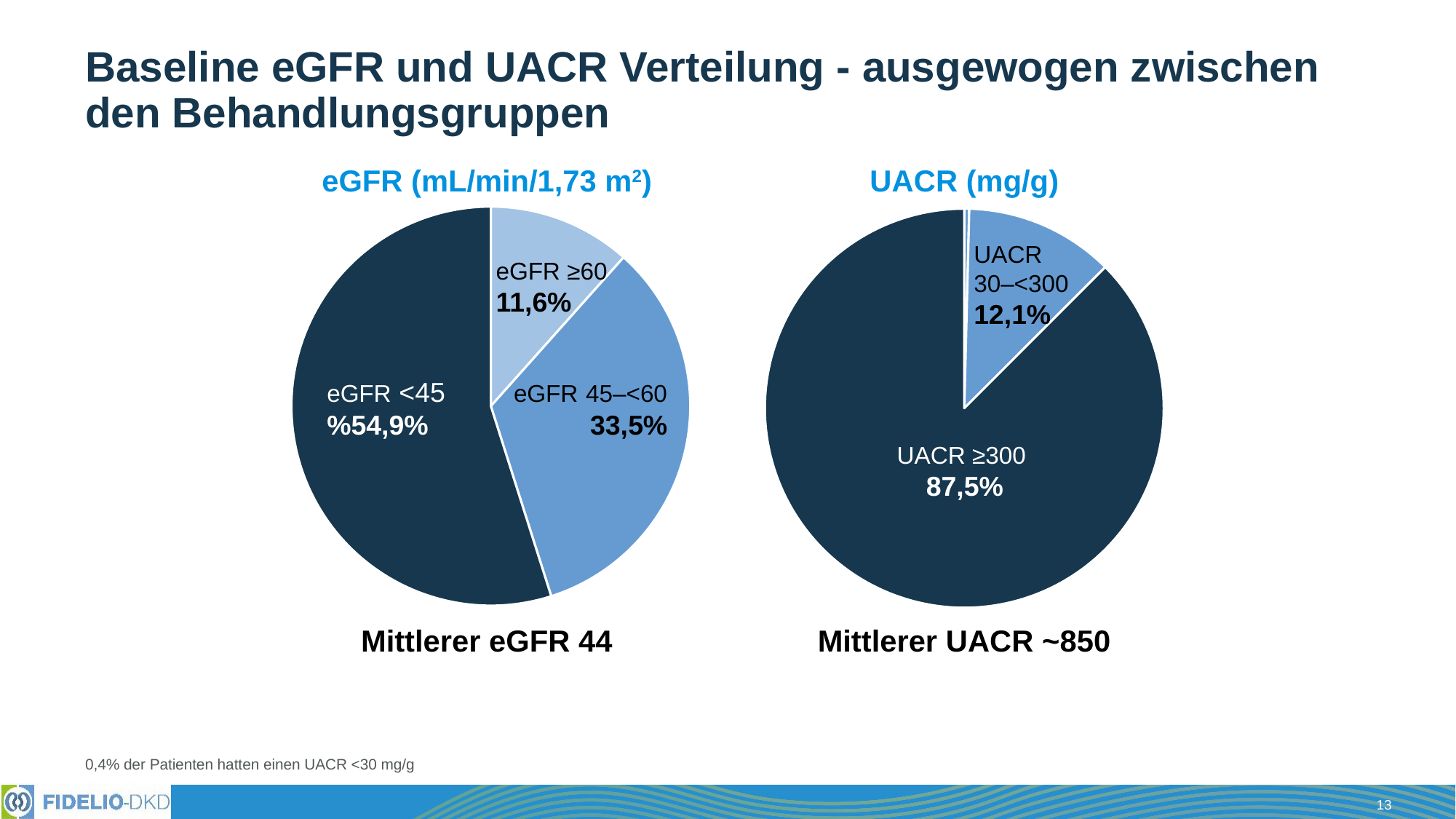
In the eGFR (mL/min/1,73 m²) chart, which category has the largest slice? eGFR <45 In the UACR (mg/g) chart, what share of patients had UACR 30–<300? 12,1% In the eGFR (mL/min/1,73 m²) chart, which category has the smallest slice? eGFR ≥60 In the eGFR (mL/min/1,73 m²) chart, what share of patients had eGFR ≥60? 11,6% What kind of chart is the eGFR (mL/min/1,73 m²) chart? pie chart In the eGFR (mL/min/1,73 m²) chart, what share of patients had eGFR <45? 54,9% In the eGFR (mL/min/1,73 m²) chart, what share of patients had eGFR 45–<60? 33,5% In the UACR (mg/g) chart, which is larger: UACR ≥300 or UACR 30–<300? UACR ≥300 In the UACR (mg/g) chart, what share of patients had UACR ≥300? 87,5% What mean eGFR value is stated below the eGFR (mL/min/1,73 m²) chart? Mittlerer eGFR 44 In the eGFR (mL/min/1,73 m²) chart, what is the difference in percentage points between eGFR <45 and eGFR 45–<60? 21,4 In the eGFR (mL/min/1,73 m²) chart, how many categories are shown? 3